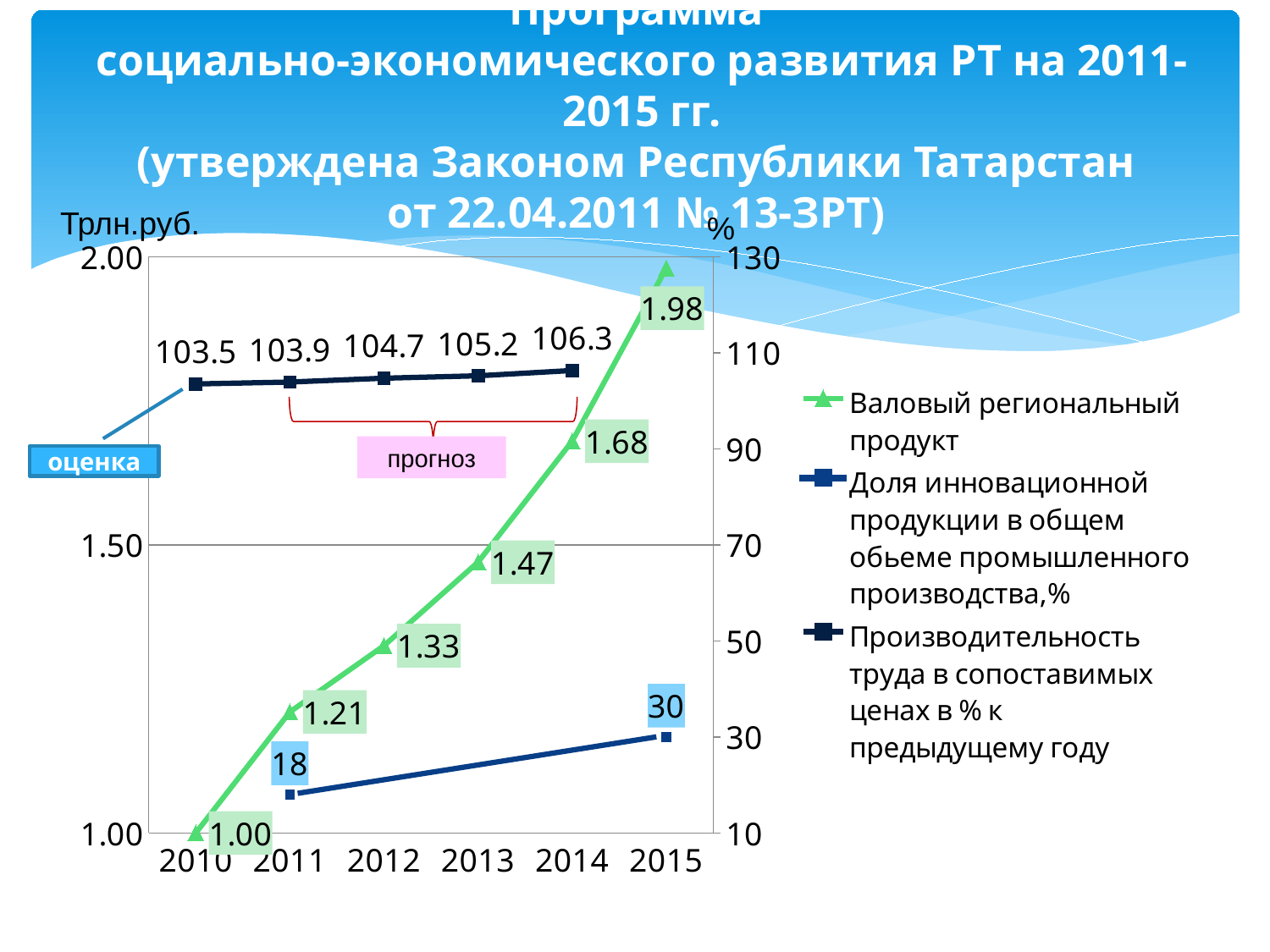
What is the value of Валовый региональный продукт in 2013? 1.47 What is the difference between Валовый региональный продукт in 2015 and in 2014? 0.30 What is the difference between Доля инновационной продукции in 2015 and in 2011? 12 How many series does the legend list? 3 What kind of chart is shown on the slide? Line chart In which year is Валовый региональный продукт lowest? 2010 Does Валовый региональный продукт rise or fall from 2010 to 2015? Rise What is the value of Производительность труда в сопоставимых ценах in 2012? 104.7 What is the value of Доля инновационной продукции in 2011? 18 In which year is Производительность труда в сопоставимых ценах highest? 2014 What is the value of Валовый региональный продукт in 2015? 1.98 Which is larger: Производительность труда in 2011 or in 2013? 2013